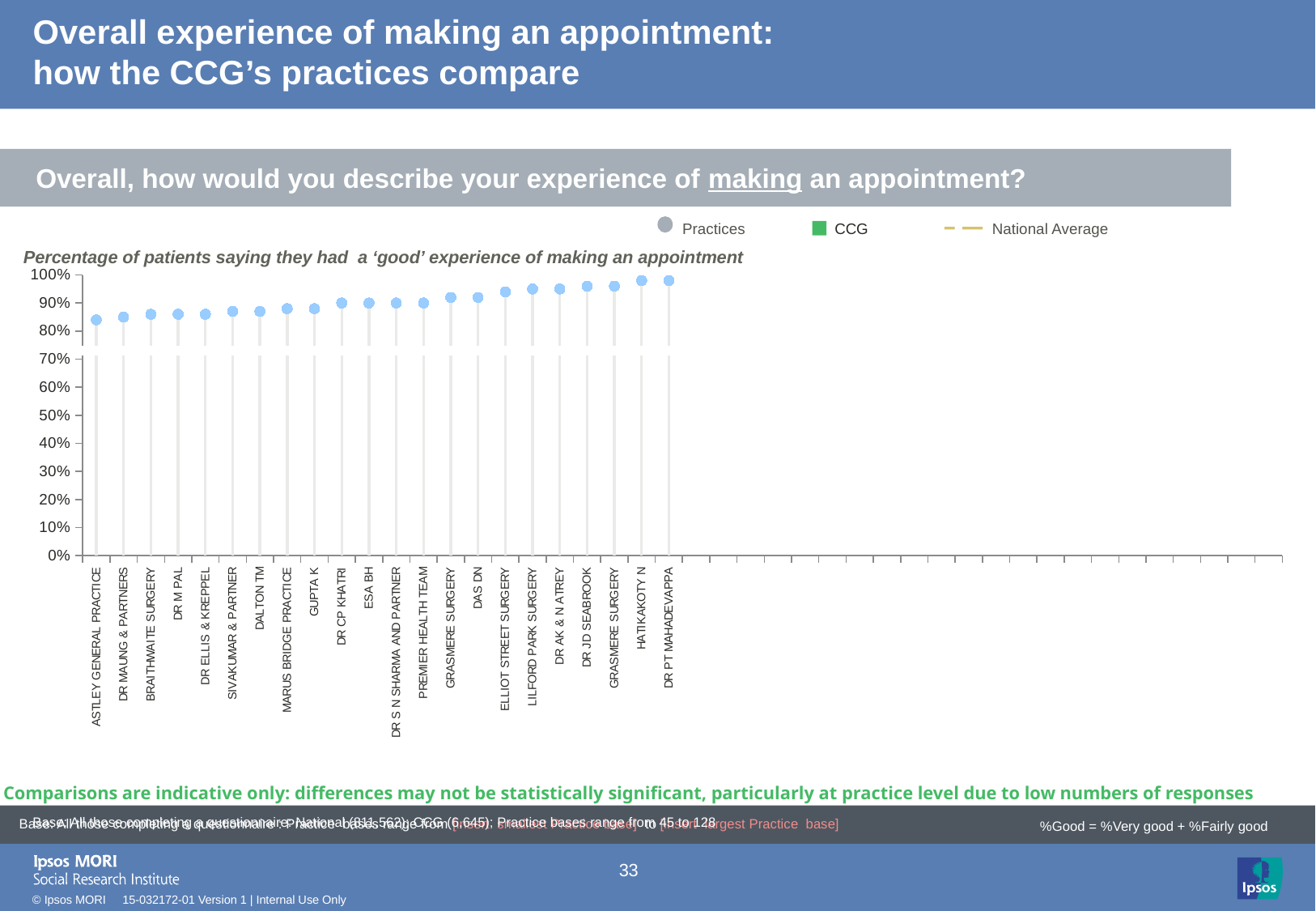
Is the value for DR MAUNG & PARTNERS greater or less than 90%? less Is the value for ELLIOT STREET SURGERY greater or less than 90%? greater What are the three entries listed in the chart legend? Practices, CCG, National Average Is the value for ASTLEY GENERAL PRACTICE greater or less than 80%? greater How many practices are plotted on the chart? 22 Which practice is plotted first (leftmost) on the x axis? ASTLEY GENERAL PRACTICE How many series does the chart legend list? 3 Do the plotted values rise or fall from left to right along the x axis? rise What kind of chart is shown on the slide? dot chart